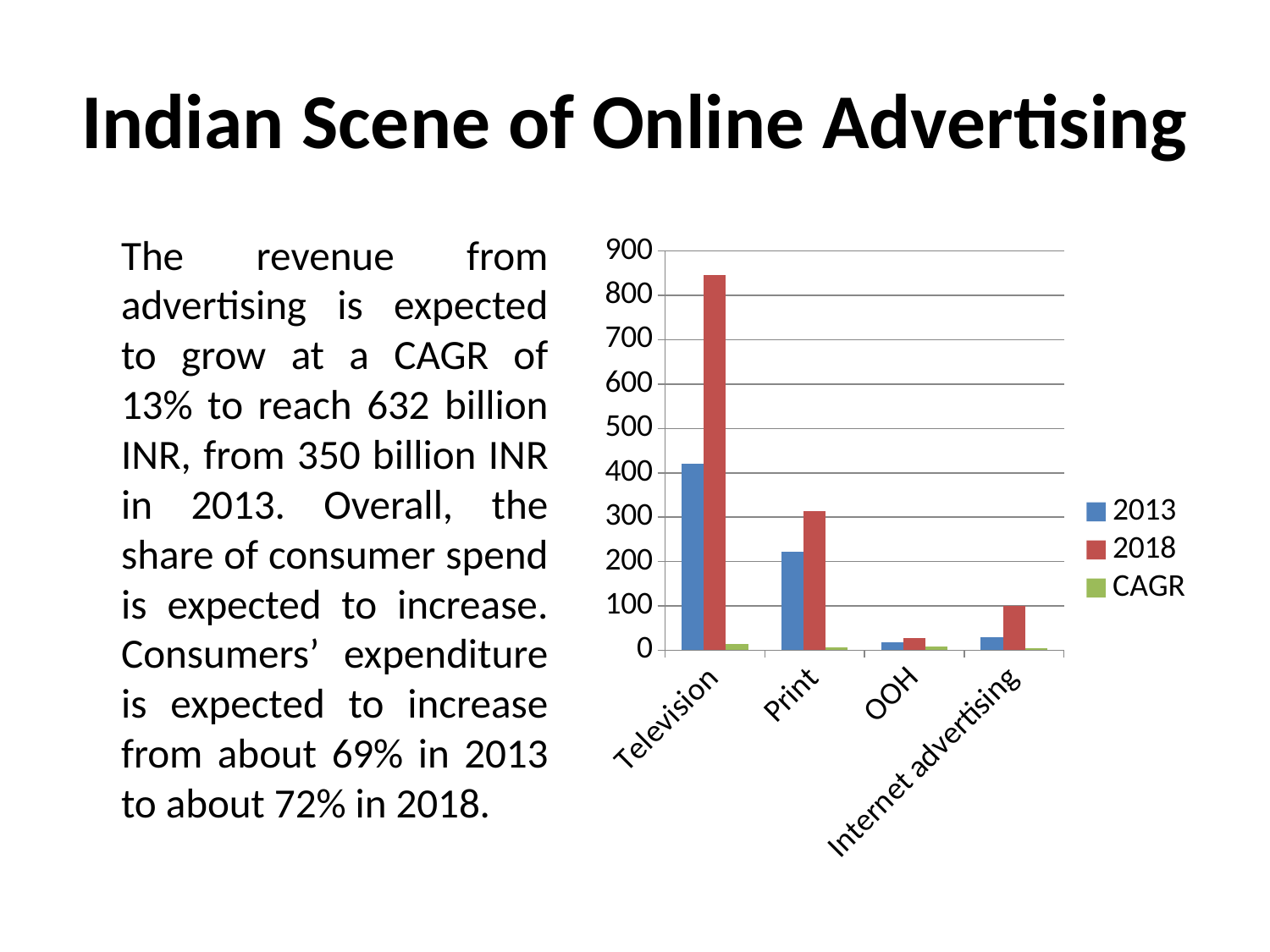
Which series are listed in the chart's legend? 2013, 2018, CAGR Which is larger, the 2018 value for Print or the 2018 value for Internet advertising? Print How many series does the chart's legend list? 3 Is the 2013 value for Print greater or less than 200? greater Is the 2013 value for Television greater or less than 400? greater Which category has the lowest 2018 value? OOH Which category has the highest 2018 value? Television What kind of chart is shown on the slide? bar chart Is the 2018 value for Television greater or less than 800? greater How many categories are shown on the x axis of the chart? 4 Which category has the highest 2013 value? Television